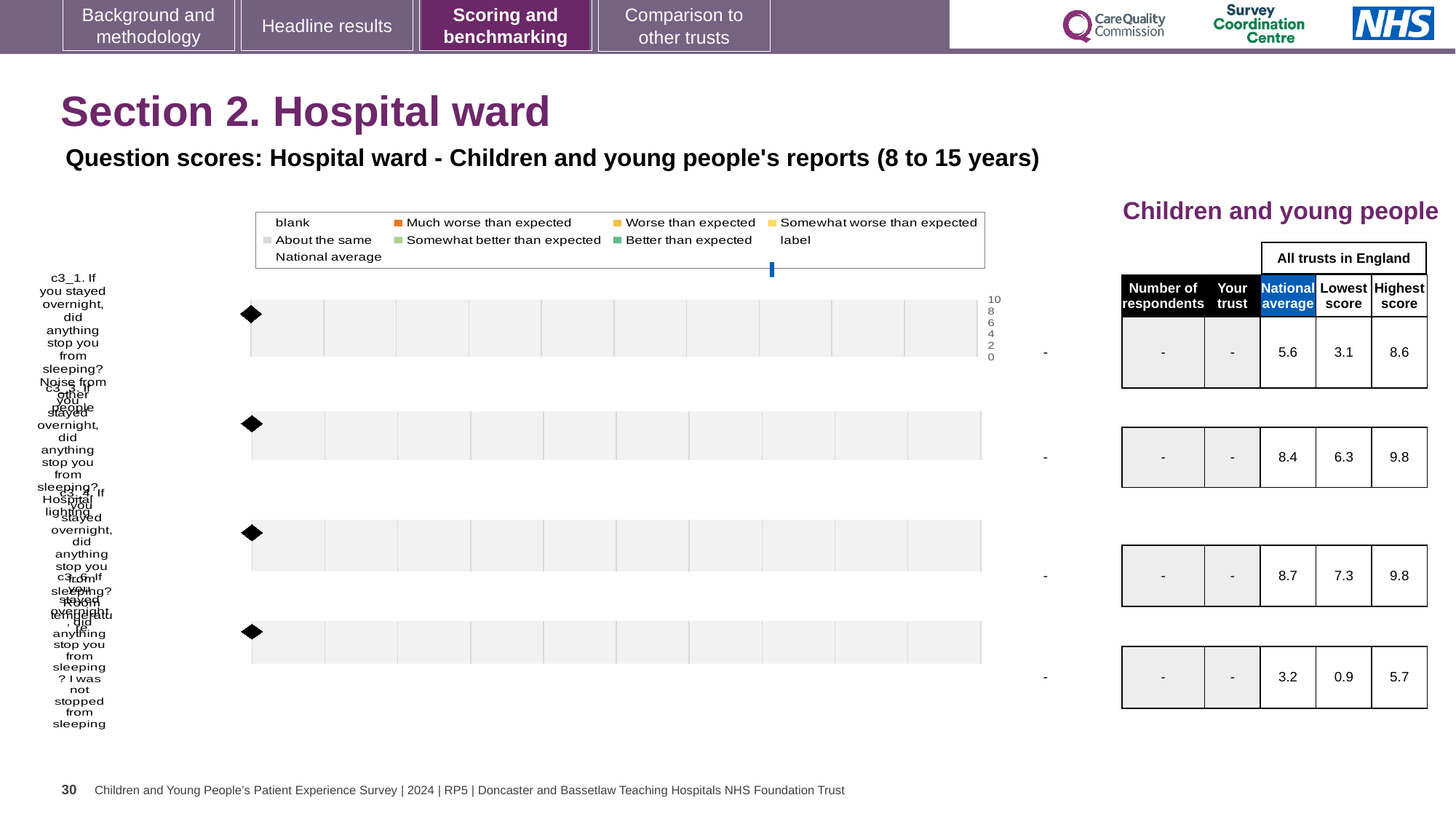
What kind of chart is shown on the slide? bar chart In the table next to the chart, is the national average for c3_3 or c3_4 larger? c3_4 In the table next to the chart, what is the national average for c3_4 (room temperature)? 8.7 What is the highest value shown on the chart's axis? 10 In the table next to the chart, what is the national average for c3_6 (I was not stopped from sleeping)? 3.2 Which legend entry is shown with an orange marker? Much worse than expected In the table next to the chart, which question has the highest national average? c3_4 (room temperature) In the table next to the chart, what is the national average for c3_3 (hospital lighting)? 8.4 How many question categories (bars) are plotted in the chart? 4 In the table next to the chart, what is the difference between the highest score and the lowest score for c3_1? 5.5 In the table next to the chart, what is the national average for c3_1 (noise from other people stopping you from sleeping)? 5.6 In the table next to the chart, which question has the lowest national average? c3_6 (I was not stopped from sleeping)